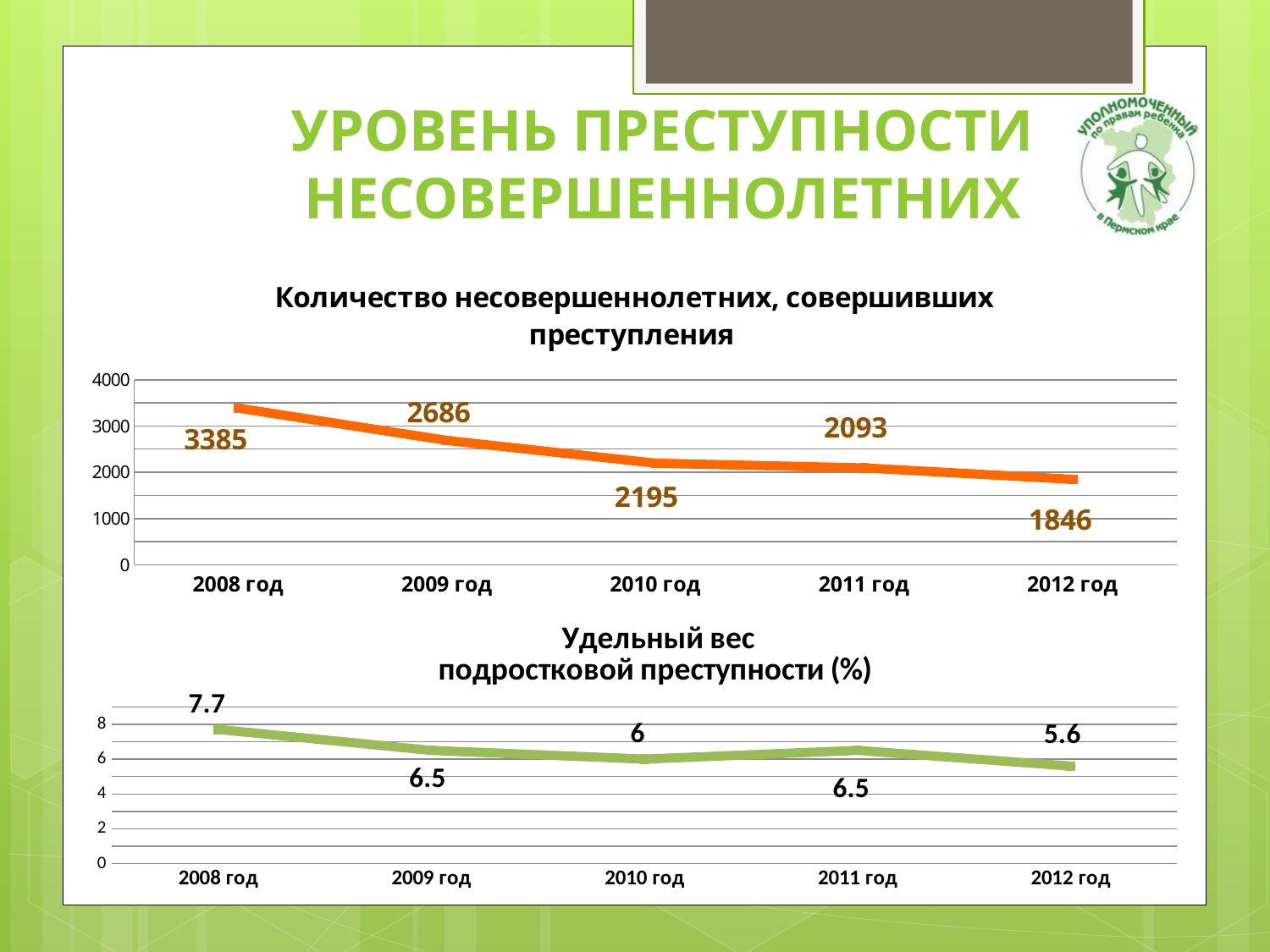
In the top chart (Количество несовершеннолетних, совершивших преступления), do the values rise or fall from 2008 год to 2012 год? fall In the bottom chart (Удельный вес подростковой преступности (%)), which year has the lowest value? 2012 год In the bottom chart (Удельный вес подростковой преступности (%)), what is the difference between the values for 2008 год and 2012 год? 2.1 In the top chart (Количество несовершеннолетних, совершивших преступления), how many years are plotted? 5 In the top chart (Количество несовершеннолетних, совершивших преступления), what is the difference between the values for 2008 год and 2009 год? 699 In the bottom chart (Удельный вес подростковой преступности (%)), what is the value for 2010 год? 6 What kind of chart is the top chart (Количество несовершеннолетних, совершивших преступления)? line chart In the bottom chart (Удельный вес подростковой преступности (%)), which is larger, the value for 2008 год or the value for 2010 год? 2008 год In the bottom chart (Удельный вес подростковой преступности (%)), what is the value for 2008 год? 7.7 In the top chart (Количество несовершеннолетних, совершивших преступления), what is the value for 2012 год? 1846 In the top chart (Количество несовершеннолетних, совершивших преступления), what is the value for 2008 год? 3385 In the top chart (Количество несовершеннолетних, совершивших преступления), which year has the highest value? 2008 год